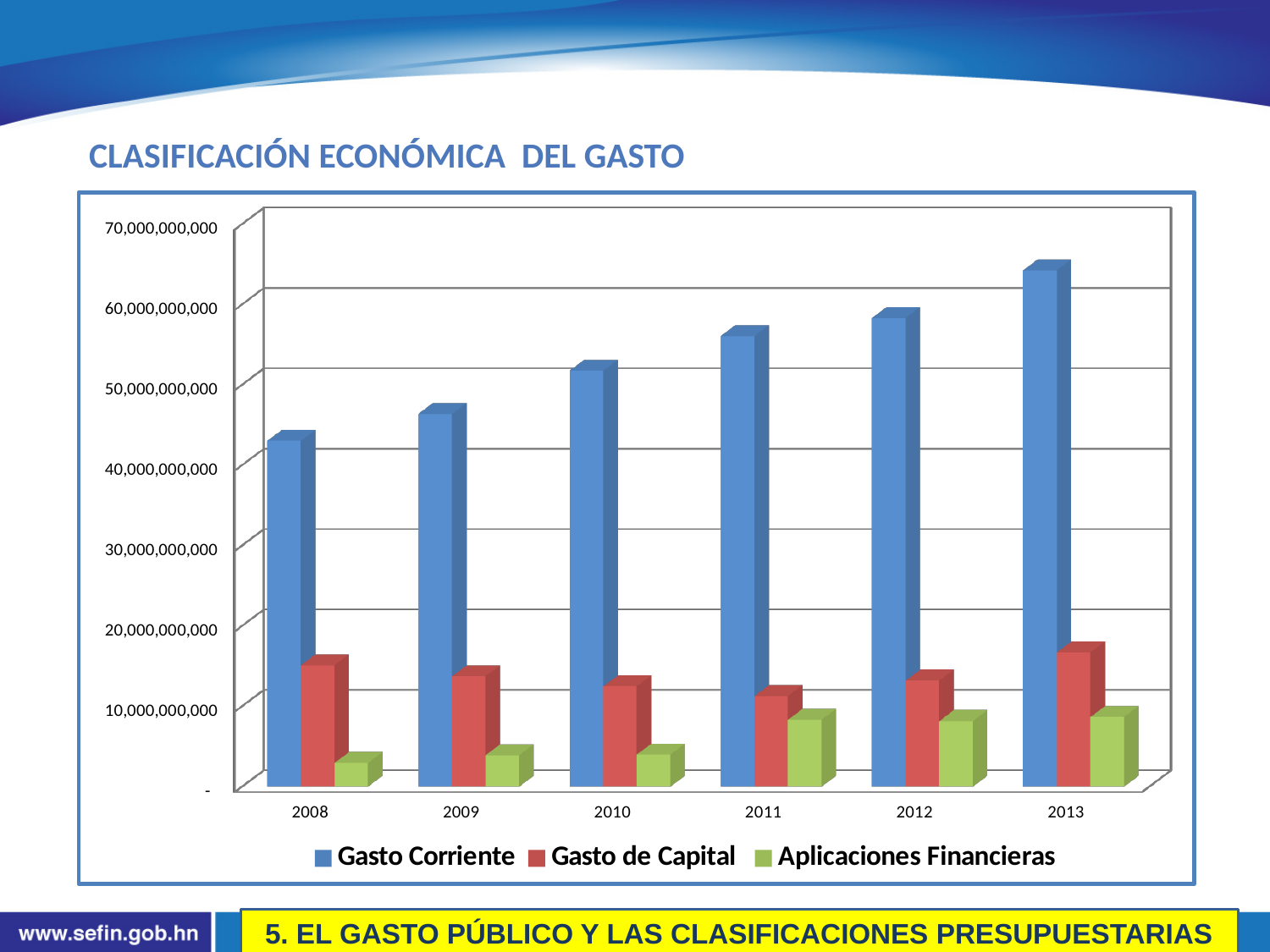
Is the value for Gasto Corriente in 2013 greater or less than 60,000,000,000? greater Is the value for Aplicaciones Financieras in 2008 greater or less than 10,000,000,000? less Which is larger in 2010, Gasto Corriente or Gasto de Capital? Gasto Corriente How many series does the legend list? 3 In which year is Gasto Corriente highest? 2013 How many years are shown on the x axis? 6 What kind of chart is shown on the slide? bar chart What is the title above the chart? CLASIFICACIÓN ECONÓMICA DEL GASTO Is the value for Gasto Corriente in 2008 greater or less than 50,000,000,000? less In which year is Gasto Corriente lowest? 2008 Does Gasto Corriente rise or fall from 2008 to 2013? rise Which series is shown in green? Aplicaciones Financieras